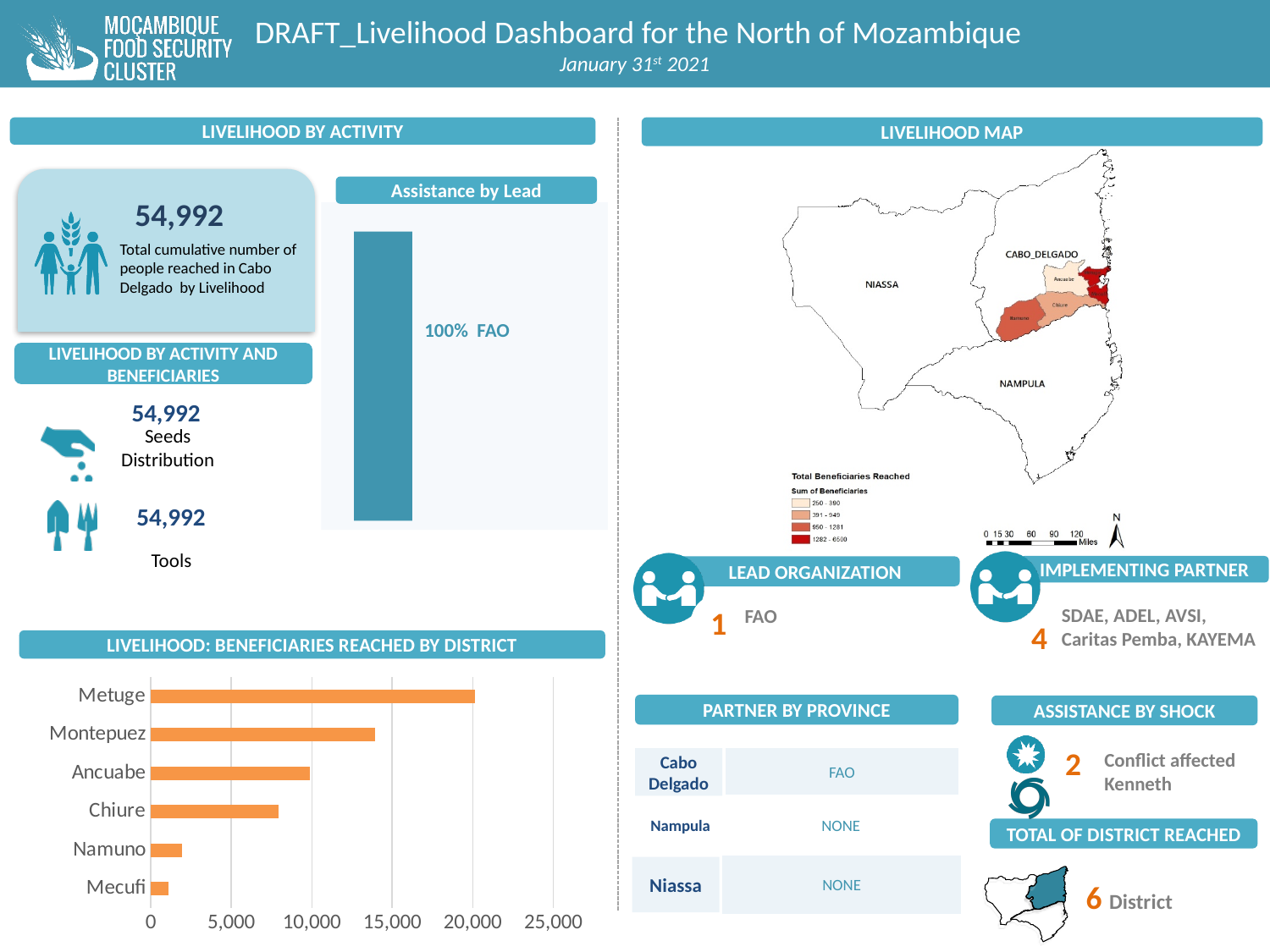
In the 'LIVELIHOOD: BENEFICIARIES REACHED BY DISTRICT' chart, is the value for Metuge greater or less than 15,000? greater In the 'LIVELIHOOD: BENEFICIARIES REACHED BY DISTRICT' chart, which has more beneficiaries, Montepuez or Ancuabe? Montepuez How many districts are shown in the 'LIVELIHOOD: BENEFICIARIES REACHED BY DISTRICT' chart? 6 In the 'Assistance by Lead' chart, what share of assistance is attributed to FAO? 100% In the 'LIVELIHOOD: BENEFICIARIES REACHED BY DISTRICT' chart, which district has the lowest number of beneficiaries? Mecufi What is the highest value shown on the x axis of the 'LIVELIHOOD: BENEFICIARIES REACHED BY DISTRICT' chart? 25,000 In the 'LIVELIHOOD: BENEFICIARIES REACHED BY DISTRICT' chart, is the value for Montepuez greater or less than 15,000? less What kind of chart is 'LIVELIHOOD: BENEFICIARIES REACHED BY DISTRICT'? bar chart In the 'LIVELIHOOD: BENEFICIARIES REACHED BY DISTRICT' chart, which has more beneficiaries, Chiure or Namuno? Chiure In the 'LIVELIHOOD: BENEFICIARIES REACHED BY DISTRICT' chart, is the value for Namuno greater or less than 5,000? less In the 'LIVELIHOOD: BENEFICIARIES REACHED BY DISTRICT' chart, which district has the highest number of beneficiaries? Metuge